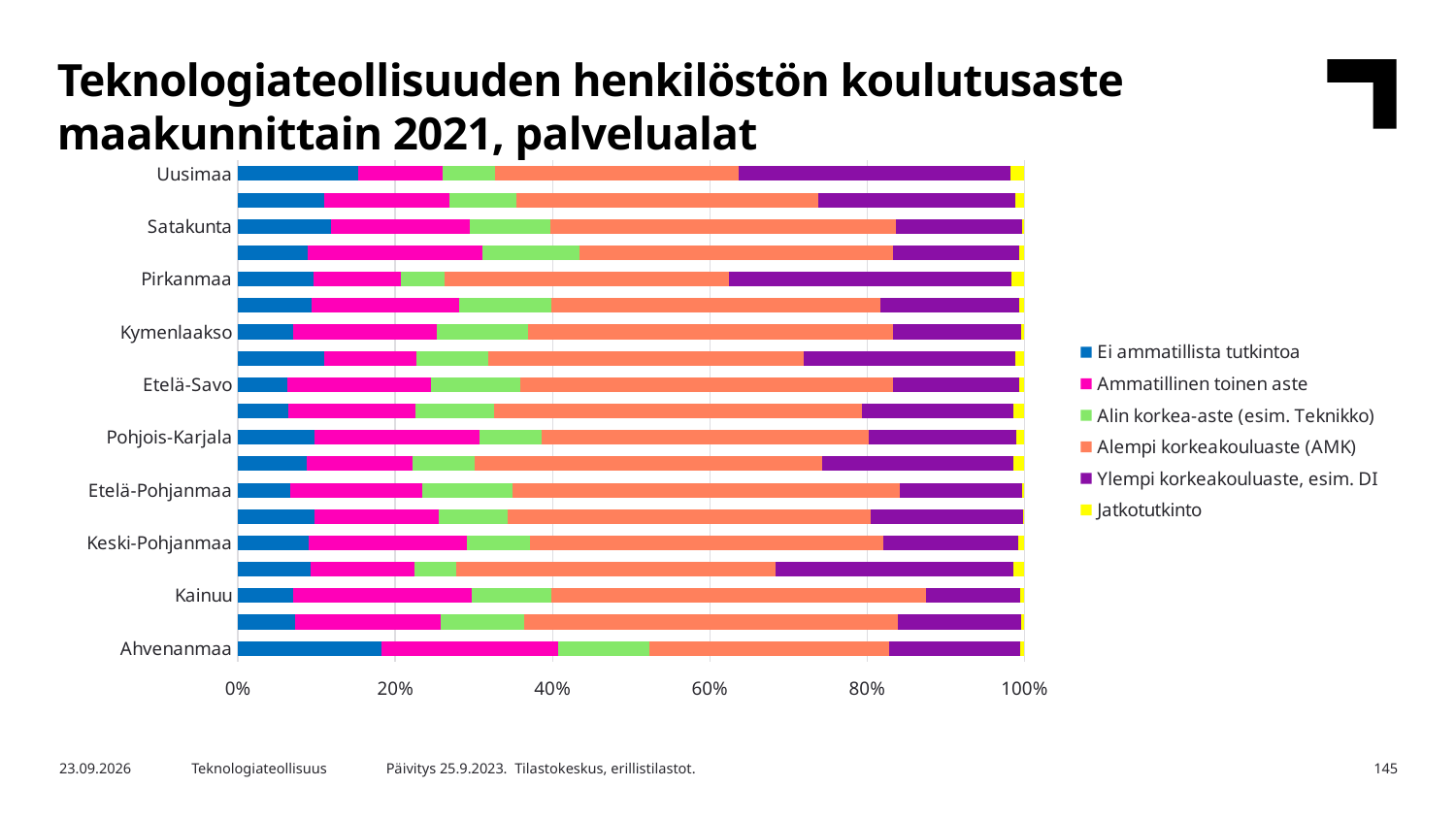
What does each stacked bar total? 100% Is the 'Ei ammatillista tutkintoa' share for Ahvenanmaa greater or less than 20%? less Which legend entry is shown in yellow? Jatkotutkinto Which has the larger 'Ei ammatillista tutkintoa' share, Ahvenanmaa or Kainuu? Ahvenanmaa Is the 'Ei ammatillista tutkintoa' share for Uusimaa greater or less than 20%? less How many series does the legend list? 6 Is the 'Alempi korkeakouluaste (AMK)' share for Kainuu greater or less than 40%? greater What is the title of the chart on the slide? Teknologiateollisuuden henkilöstön koulutusaste maakunnittain 2021, palvelualat Which region has the largest 'Ei ammatillista tutkintoa' share? Ahvenanmaa How many bars are plotted in the chart? 19 What kind of chart is shown on the slide? Stacked bar chart